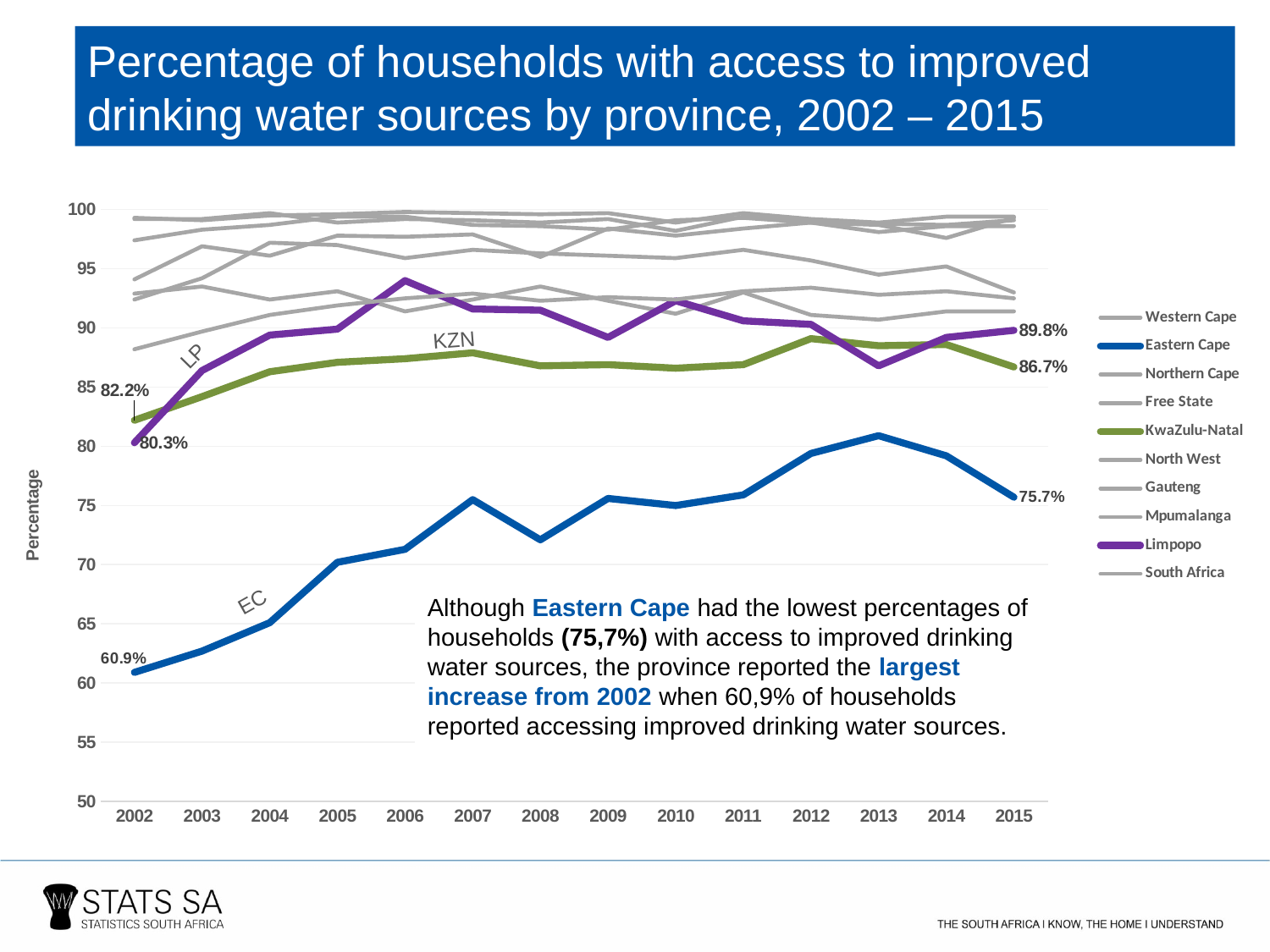
What was the percentage for Eastern Cape in 2015? 75.7% Is the value for Eastern Cape in 2008 greater or less than 75? less How many years are shown along the x axis? 14 What was the percentage for Limpopo in 2015? 89.8% What was the percentage for Eastern Cape in 2002? 60.9% In 2015, which was larger: the value for Limpopo or the value for KwaZulu-Natal? Limpopo Which province had the lowest percentage in 2015? Eastern Cape What type of chart is shown on the slide? Line chart What was the percentage for KwaZulu-Natal in 2002? 82.2% By how many percentage points did Limpopo's value increase from 2002 to 2015? 9.5 How many series does the legend list? 10 By how many percentage points did Eastern Cape's value increase from 2002 to 2015? 14.8